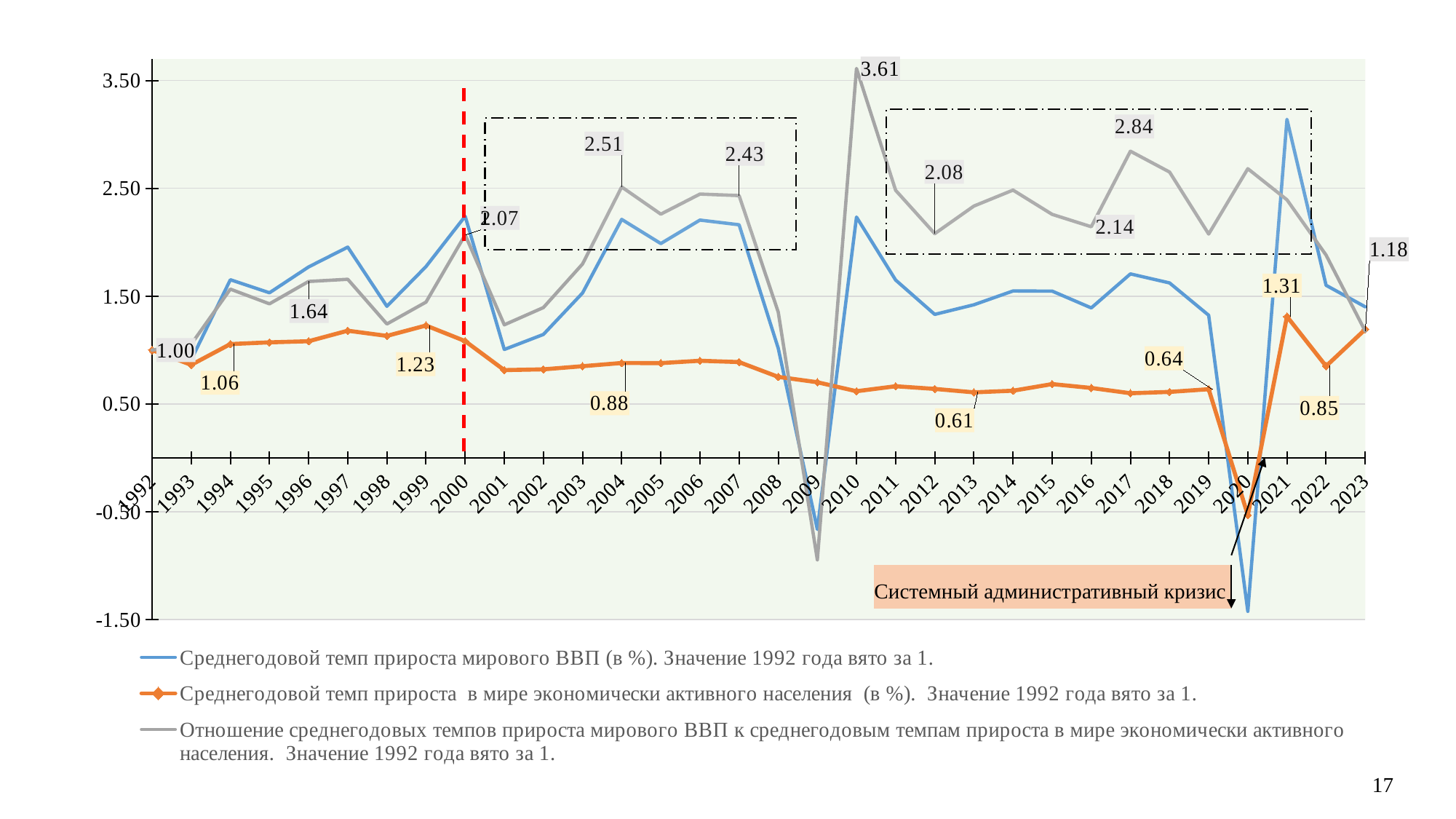
Which is larger for the orange series: the value in 2004 or the value in 2019? 2004 In which year does the ratio series (gray line) reach its highest value? 2010 What is the difference between the ratio series values in 2010 and 2017? 0.77 What is the value of the ratio series (gray line) in 2017? 2.84 Is the value of the world GDP growth series (blue line) in 2020 greater or less than -0.50? less What text is written in the highlighted box near the 2020 dip? Системный административный кризис What is the difference between the orange series values in 2021 and 2022? 0.46 What kind of chart is shown on the slide? line chart What is the value of the ratio series (Отношение среднегодовых темпов прироста...) in 2010? 3.61 What is the value of the economically active population growth series (orange line) in 2021? 1.31 What is the value of the economically active population growth series (orange line) in 2013? 0.61 How many series does the legend list? 3